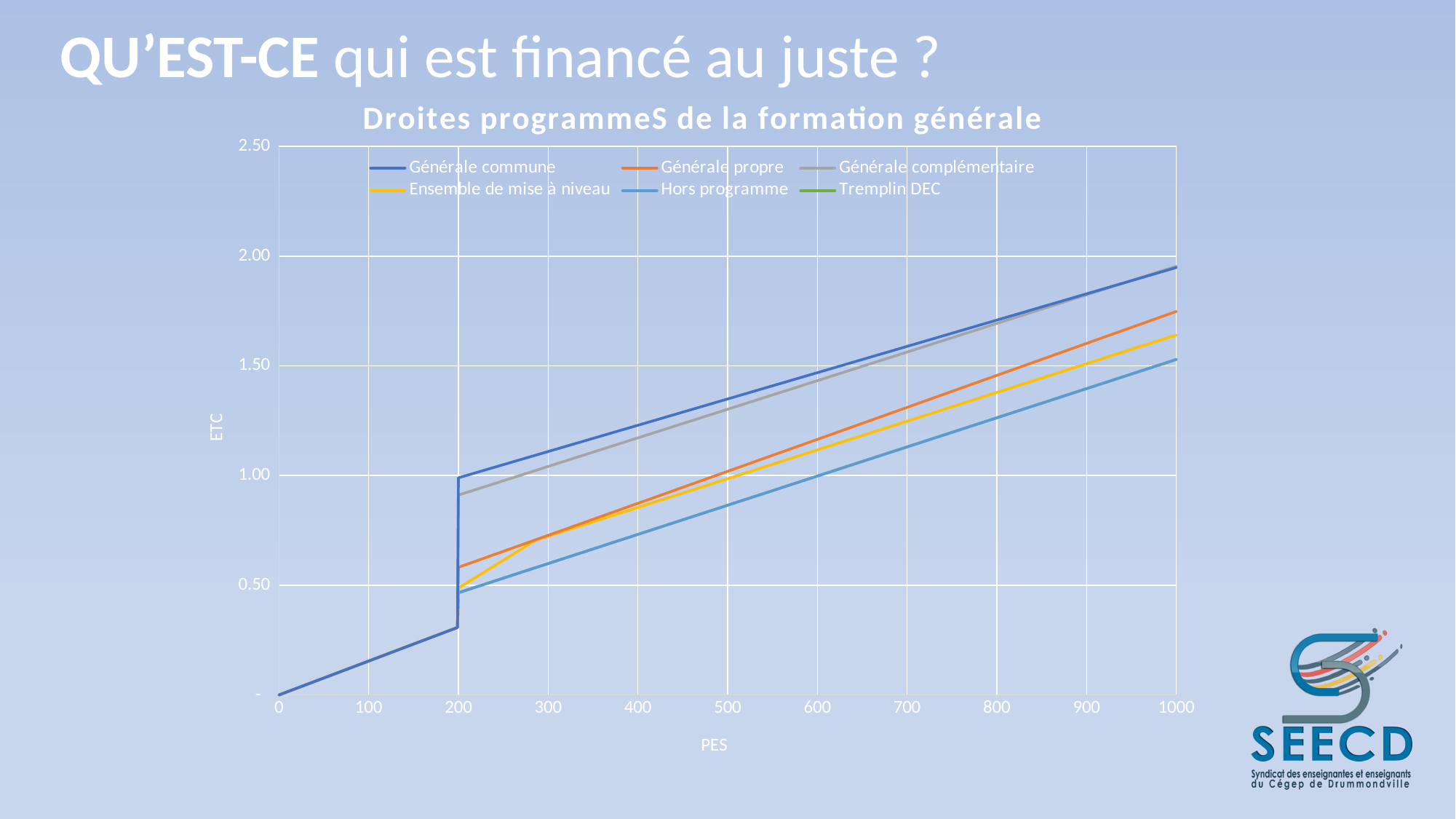
What is the title of the chart? Droites programmeS de la formation générale Is the value of Générale propre at PES 1000 greater or less than 1.50? greater What is the label of the vertical axis of the chart? ETC Is the value of Générale commune at PES 600 greater or less than 1.00? greater Is the value of Générale commune at PES 100 greater or less than 0.50? less Do the values of the Générale commune series rise or fall as PES increases from 200 to 1000? Rise How many series does the legend of the chart list? 6 What kind of chart is shown on the slide? Line chart At PES 500, which is higher: Générale propre or Hors programme? Générale propre At PES 1000, which is higher: Générale commune or Hors programme? Générale commune